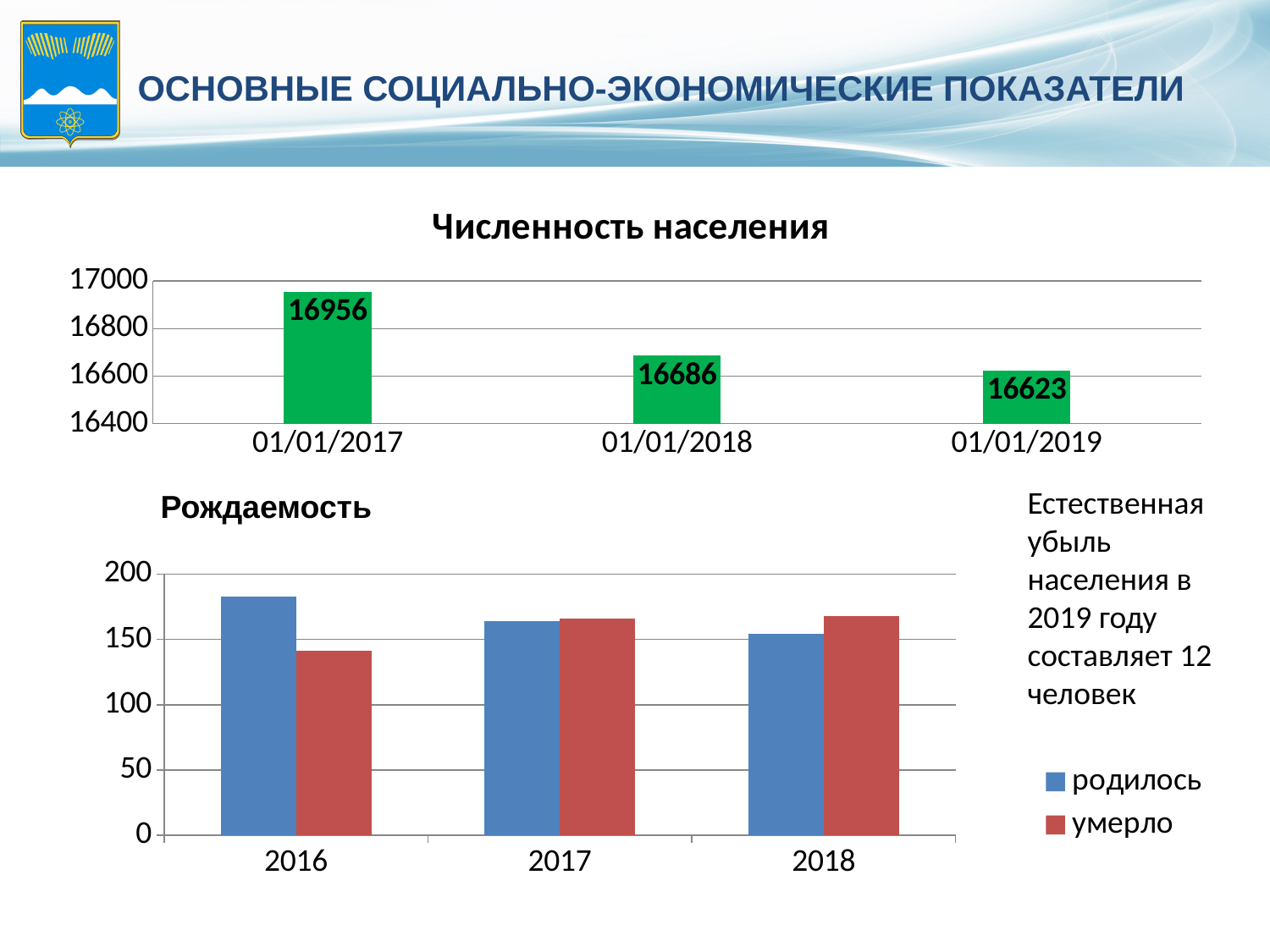
In the chart titled "Численность населения", what is the value for 01/01/2019? 16623 In the chart titled "Численность населения", what is the value for 01/01/2017? 16956 In the chart titled "Рождаемость", is the value for умерло in 2016 greater or less than 150? less In the chart titled "Рождаемость", which is larger in 2016, родилось or умерло? родилось In the chart titled "Численность населения", how many dates are shown on the x axis? 3 In the chart titled "Численность населения", which date has the highest value? 01/01/2017 In the chart titled "Рождаемость", how many series does the legend list? 2 What kind of chart is the chart titled "Рождаемость"? bar chart In the chart titled "Численность населения", do the values rise or fall from 01/01/2017 to 01/01/2019? fall In the chart titled "Численность населения", which date has the lowest value? 01/01/2019 In the chart titled "Численность населения", what is the difference between the values for 01/01/2017 and 01/01/2018? 270 In the chart titled "Рождаемость", is the value for родилось in 2016 greater or less than 150? greater